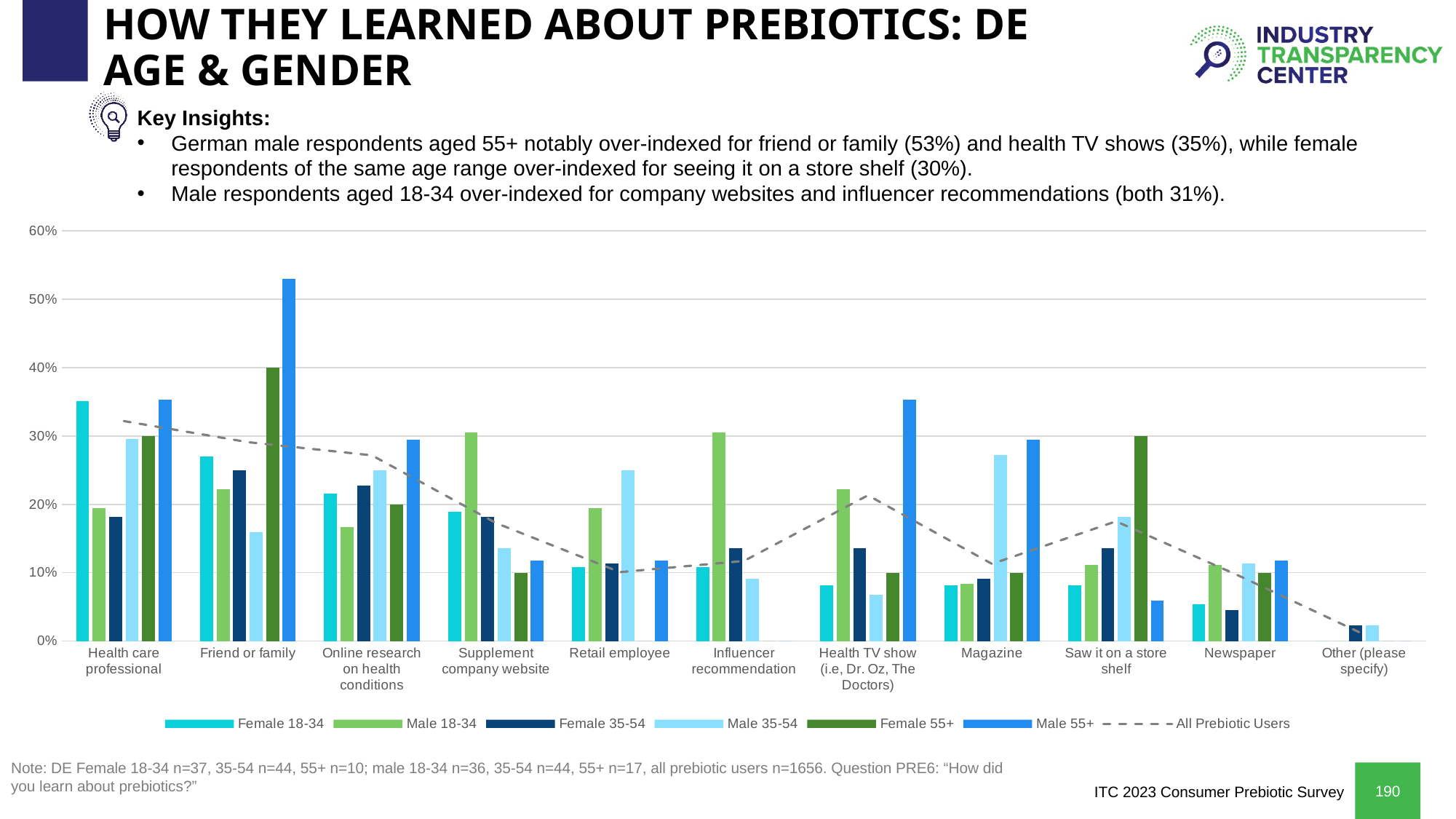
What kind of chart is shown on the slide? Bar chart (with a dashed line series) What is the value for Male 55+ in the Friend or family category? 53% Which series is drawn as a dashed line in the chart? All Prebiotic Users Which category has the highest bar in the chart overall? Friend or family Is the value for Female 35-54 in the Newspaper category greater or less than 10%? less In the Influencer recommendation category, which is larger: Male 18-34 or Female 18-34? Male 18-34 Is the value for Male 35-54 in the Magazine category greater or less than 20%? greater How many categories are shown along the x axis of the chart? 11 Which category has the highest Female 55+ value? Friend or family What is the value for Female 55+ in the Saw it on a store shelf category? 30% How many series does the chart legend list? 7 Which category has the highest Female 18-34 value? Health care professional